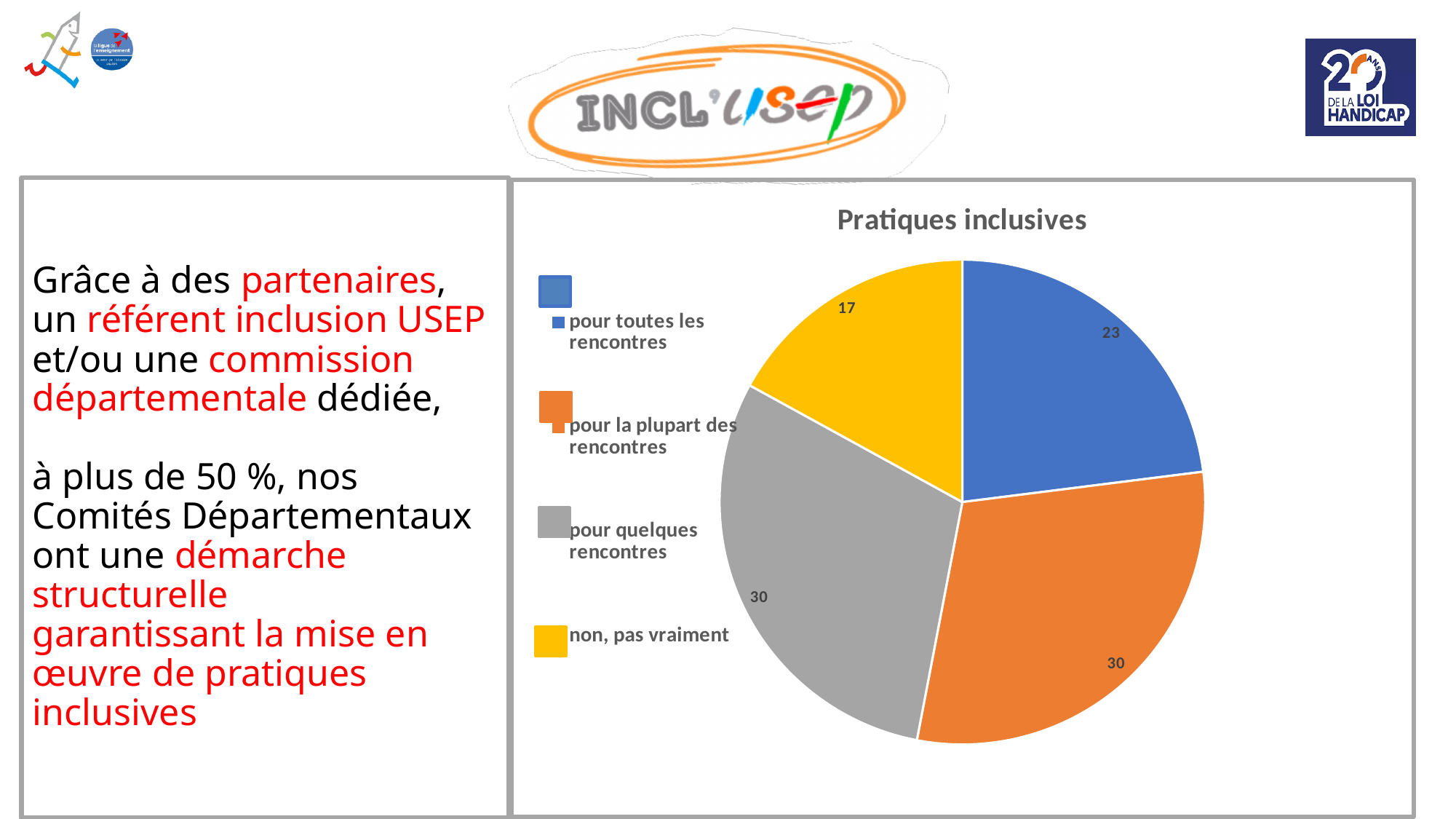
Which is larger, "pour toutes les rencontres" or "non, pas vraiment"? pour toutes les rencontres What colour is the slice for "pour quelques rencontres"? grey How many categories does the pie chart show? 4 Which category has the smallest slice? non, pas vraiment What share of the pie does "non, pas vraiment" represent? 17% What is the difference between "pour la plupart des rencontres" and "pour toutes les rencontres"? 7 What is the value for "pour toutes les rencontres"? 23 What is the value for "non, pas vraiment"? 17 What is the title of the chart? Pratiques inclusives What is the value for "pour quelques rencontres"? 30 What type of chart is shown on the slide? pie chart What is the difference between "pour toutes les rencontres" and "non, pas vraiment"? 6